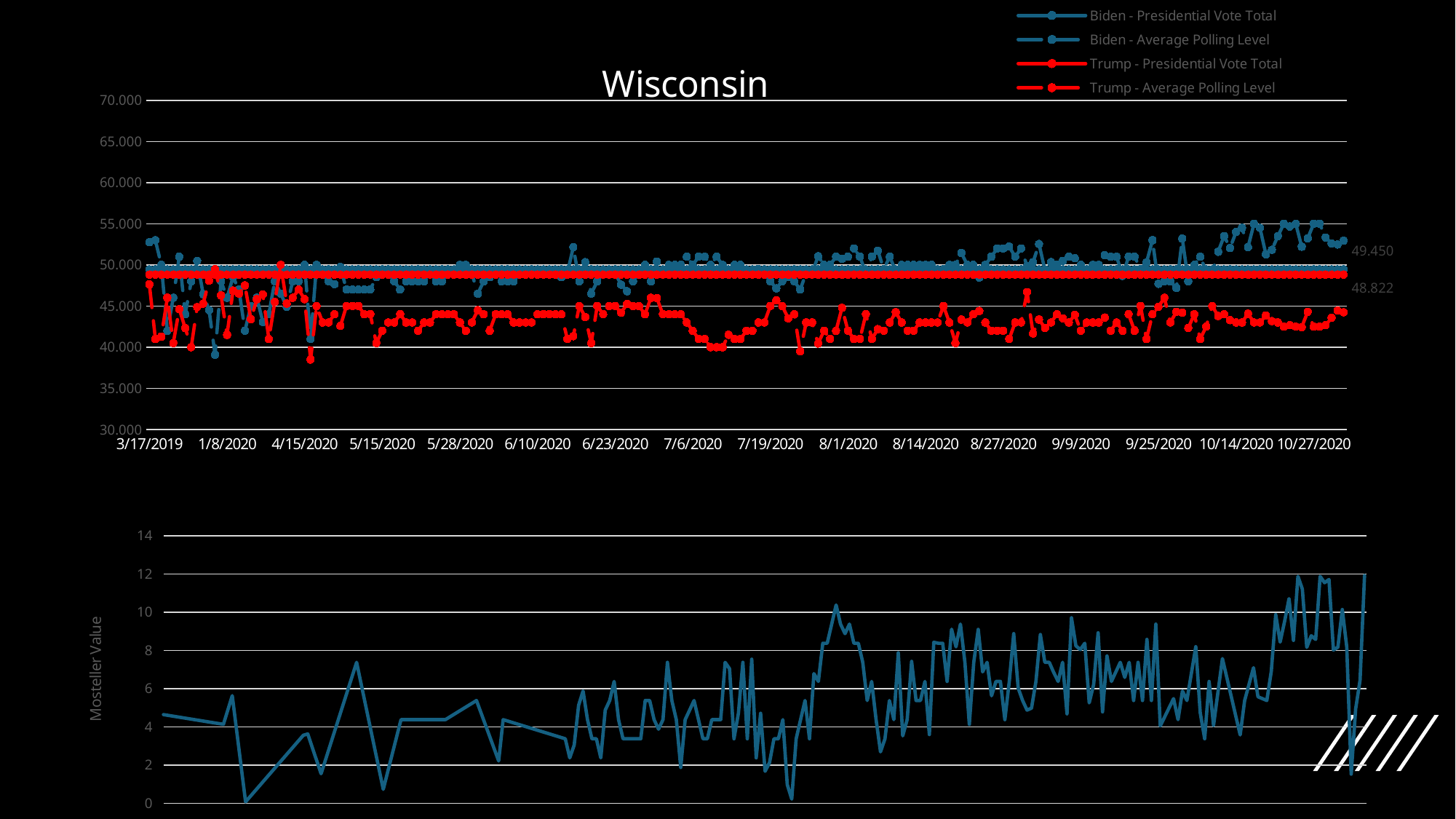
What is the title of the top chart? Wisconsin How many series does the legend of the top chart list? 4 In the top chart, is the Trump - Average Polling Level at the last date (10/27/2020) greater or less than 50.000? less In the top chart, what value is labelled for Biden - Presidential Vote Total? 49.450 In the top chart, what value is labelled for Trump - Presidential Vote Total? 48.822 In the top chart, is the Biden - Average Polling Level at the last date (10/27/2020) greater or less than 50.000? greater In the top chart, what is the difference between the Biden Presidential Vote Total (49.450) and the Trump Presidential Vote Total (48.822)? 0.628 In the bottom chart, is the highest Mosteller Value reached greater or less than 10? greater In the top chart, which is larger: the Biden Presidential Vote Total or the Trump Presidential Vote Total? Biden - Presidential Vote Total What is the y-axis label of the bottom chart? Mosteller Value What kind of chart is the top chart titled "Wisconsin"? line chart